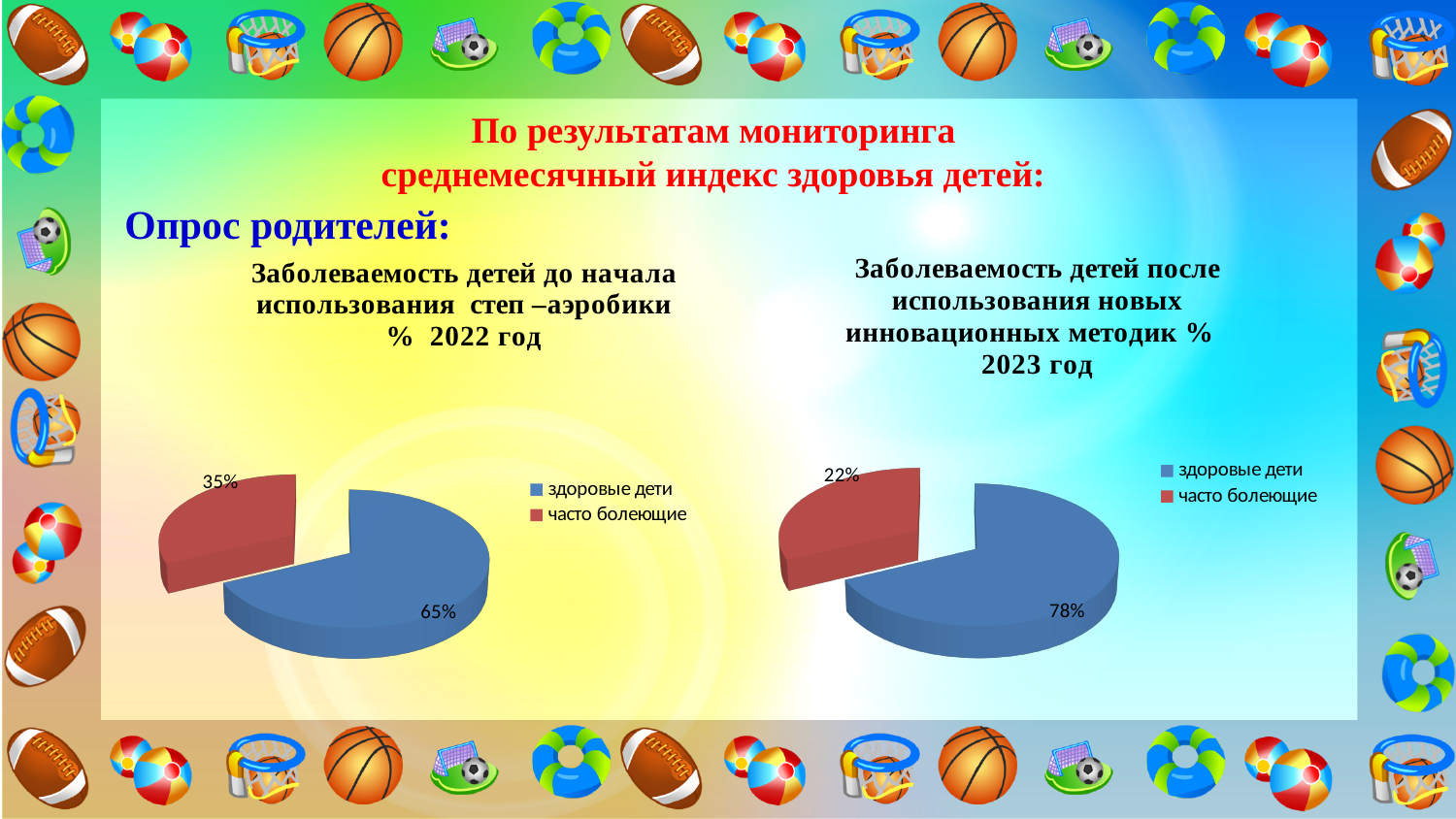
In the left pie chart (2022), what share is labelled for часто болеющие? 35% In the right pie chart (2023), what share is labelled for часто болеющие? 22% In the right pie chart (2023), which category has the smallest slice? часто болеющие Comparing the two charts, is the share of здоровые дети larger in 2022 or in 2023? 2023 In the left pie chart (2022), what share is labelled for здоровые дети? 65% In the left pie chart (2022), which category has the largest slice? здоровые дети What type of chart is used on the left side of the slide? Pie chart In the left pie chart (2022), what is the difference between the здоровые дети and часто болеющие shares? 30% How many categories does the legend of the right pie chart (2023) list? 2 How many slices does the left pie chart (2022) have? 2 In the right pie chart (2023), what colour is the slice for часто болеющие? Red In the right pie chart (2023), what share is labelled for здоровые дети? 78%